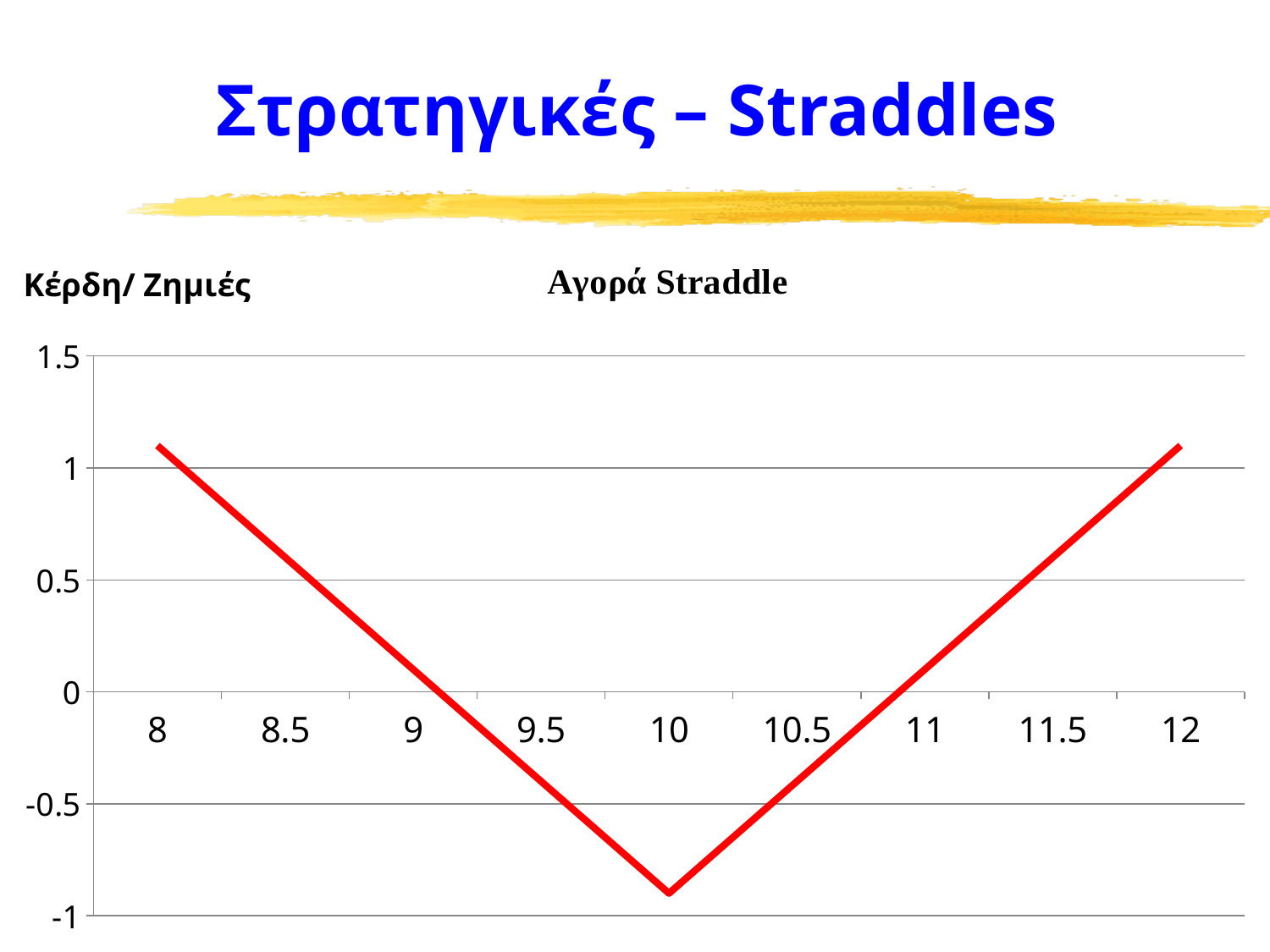
At which x-axis value does the line reach its lowest point? 10 Is the value at x = 10 greater or less than -0.5? less Is the value at x = 11 greater or less than 0? greater What colour is the plotted line? red What is the title of the chart? Αγορά Straddle How many x-axis tick labels are shown on the chart? 9 Which has the larger value, x = 9 or x = 10? 9 What kind of chart is shown on the slide? line chart Does the line rise or fall as x goes from 8 to 10? fall Is the value at x = 12 greater or less than 1? greater